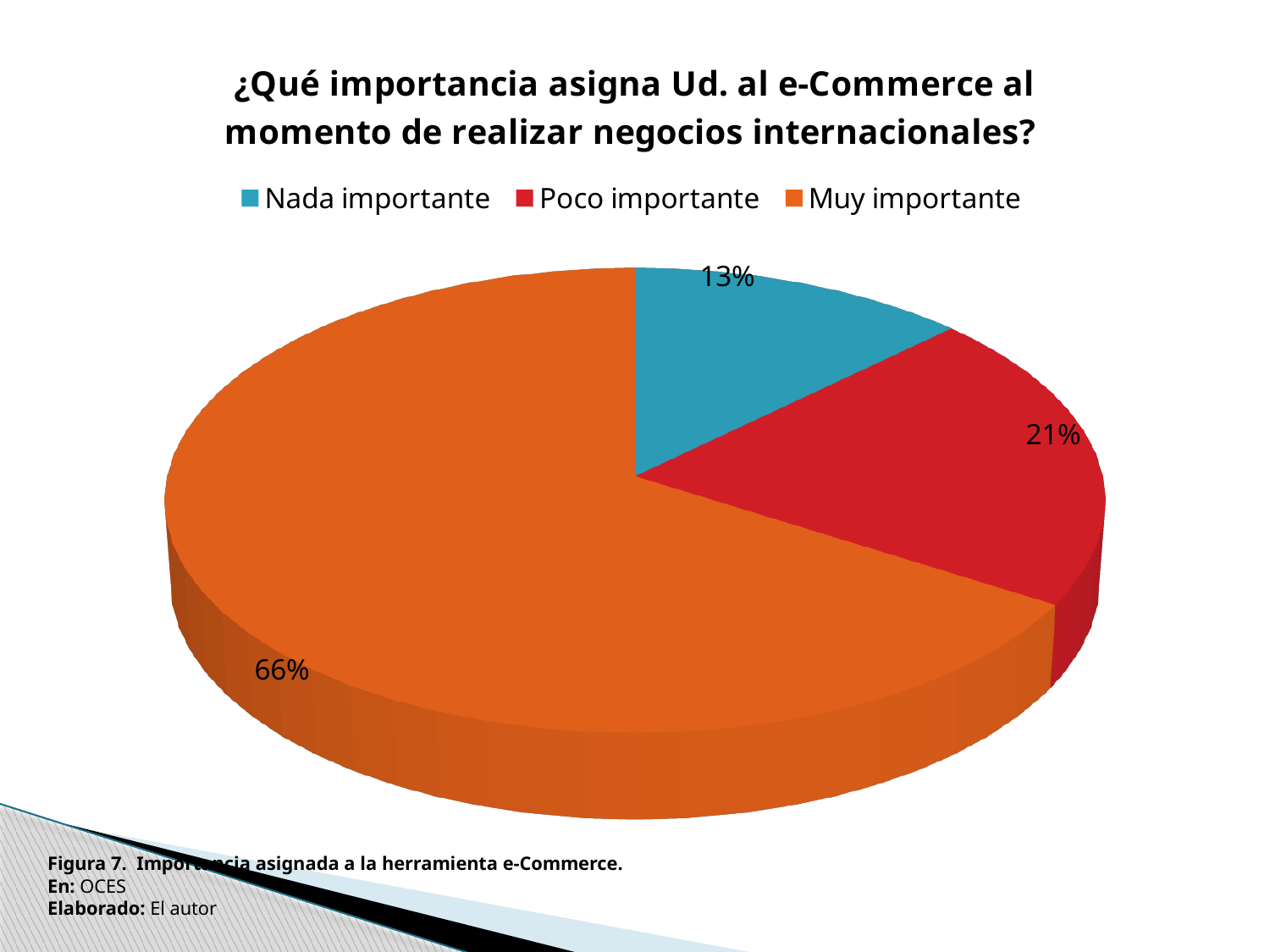
What share of the pie does "Poco importante" represent? 21% What is the title of the chart? ¿Qué importancia asigna Ud. al e-Commerce al momento de realizar negocios internacionales? What share of the pie does "Nada importante" represent? 13% What kind of chart is shown on the slide? Pie chart Which category has the largest slice of the pie? Muy importante What is the difference in percentage points between "Muy importante" and "Poco importante"? 45 Which is larger, the share for "Poco importante" or the share for "Nada importante"? Poco importante What is the difference in percentage points between "Poco importante" and "Nada importante"? 8 How many categories does the pie chart show? 3 What colour is the slice for "Nada importante"? Blue What share of the pie does "Muy importante" represent? 66% Which category has the smallest slice of the pie? Nada importante